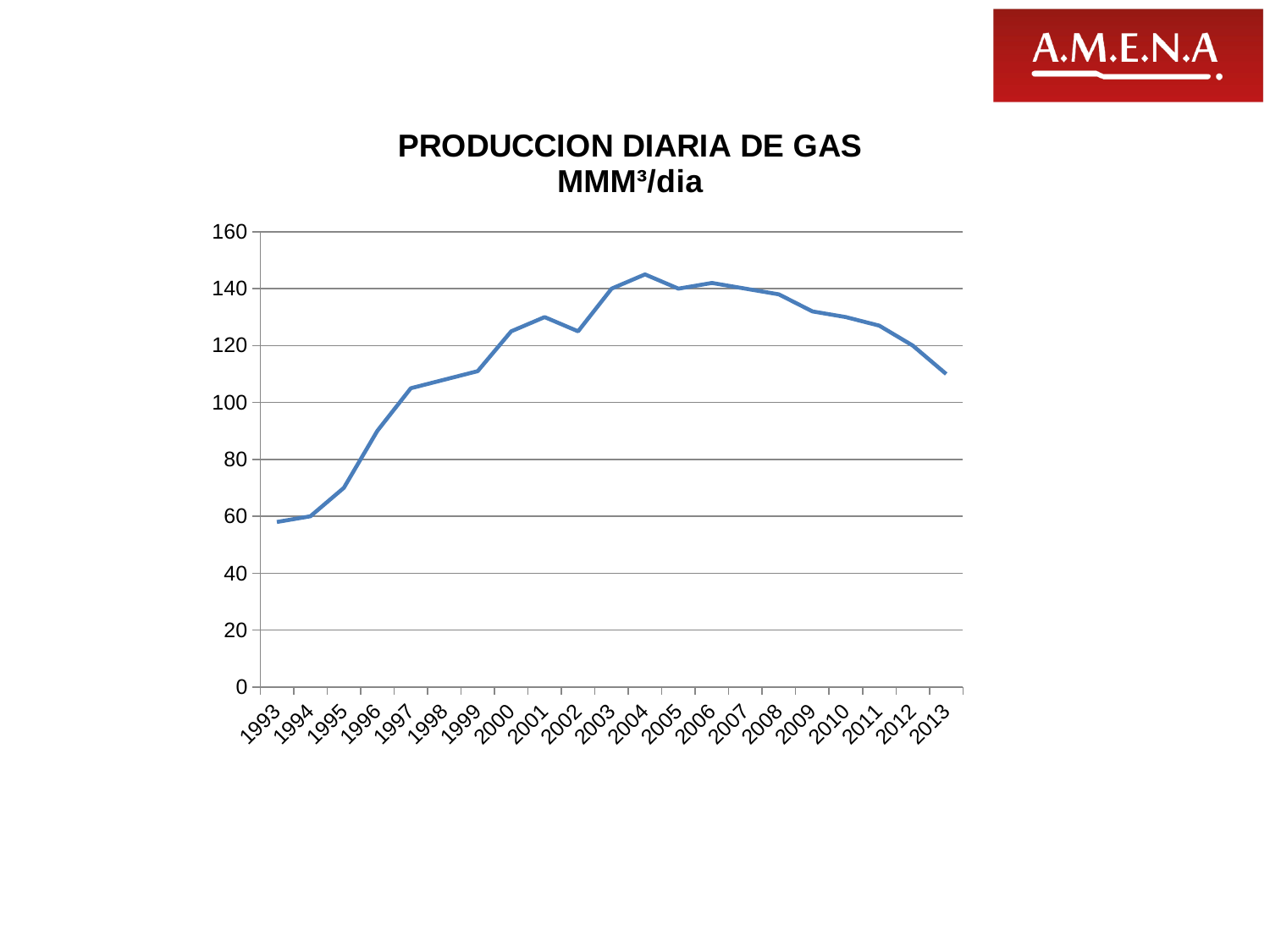
What is the title of the chart? PRODUCCION DIARIA DE GAS MMM³/dia Which year has the highest daily gas production? 2004 Is the value for 2004 greater or less than 140? greater Is the value for 2013 greater or less than 100? greater What kind of chart is shown on the slide? line chart Which year has the larger value, 1993 or 2013? 2013 Which year has the larger value, 2004 or 2013? 2004 Is the value for 1997 greater or less than 100? greater How many years are plotted along the x axis? 21 Which year has the lowest daily gas production? 1993 Does daily gas production rise or fall from 2004 to 2013? fall